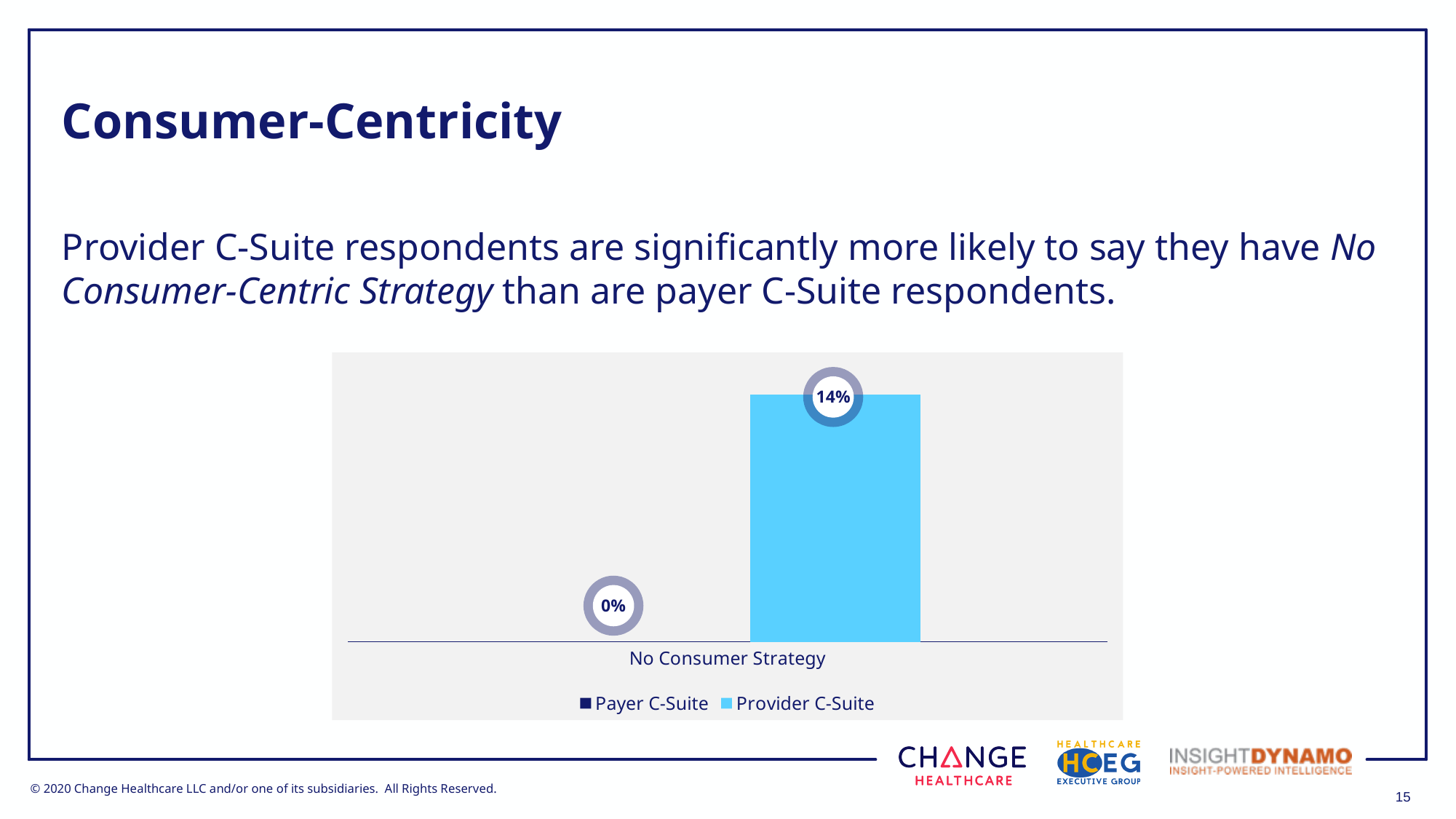
Which series has the lowest value in the chart? Payer C-Suite What is the value for Payer C-Suite in the No Consumer Strategy category? 0% What colour is the Provider C-Suite series in the legend? Light blue Which series has the higher value for No Consumer Strategy, Payer C-Suite or Provider C-Suite? Provider C-Suite How many series does the legend list? 2 What is the difference between the Provider C-Suite and Payer C-Suite values for No Consumer Strategy? 14% What is the category label shown on the x axis? No Consumer Strategy How many categories are shown on the x axis? 1 What kind of chart is shown on the slide? Bar chart What is the value for Provider C-Suite in the No Consumer Strategy category? 14% Which series has the highest value in the chart? Provider C-Suite